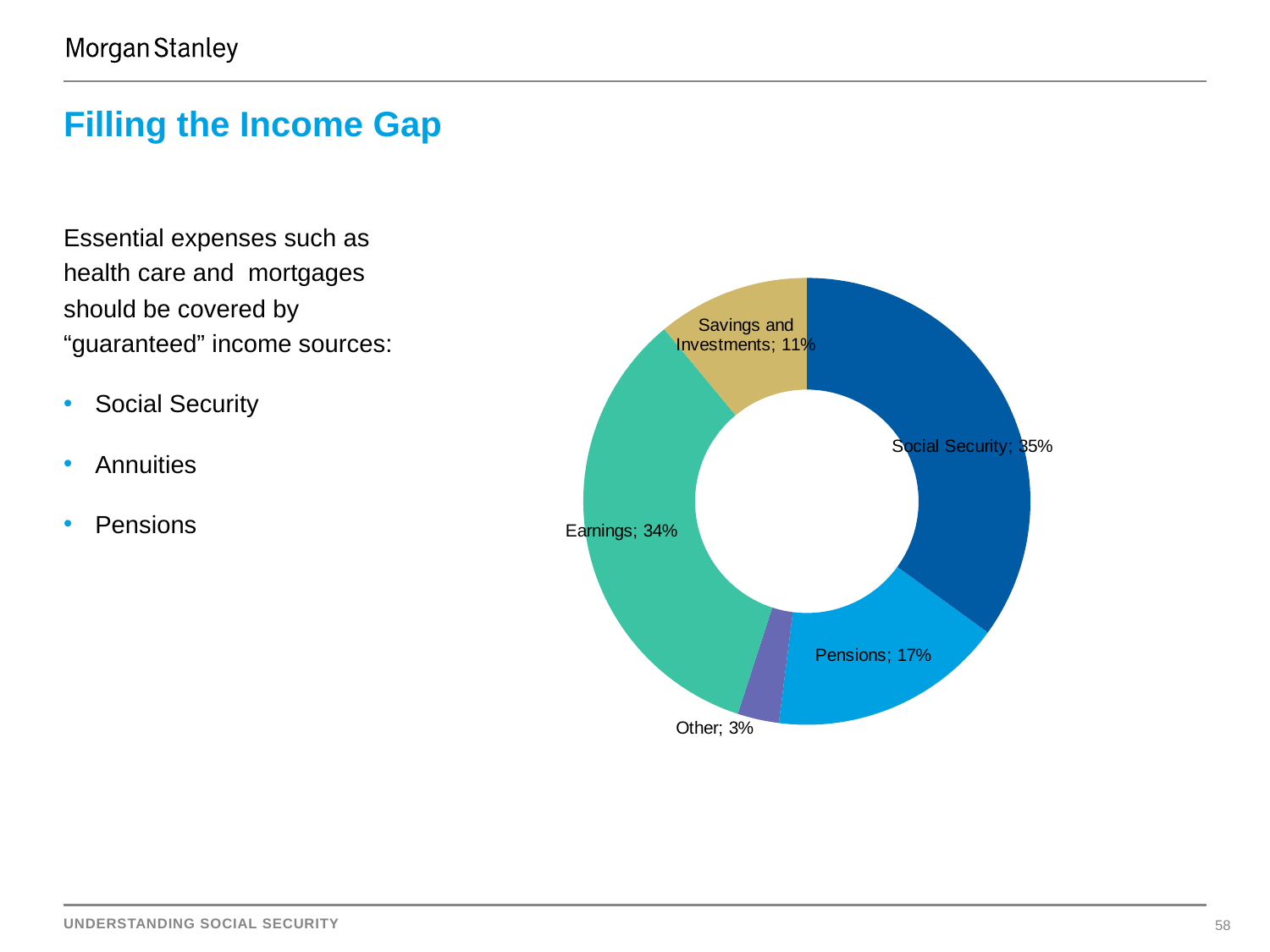
Which is larger, the Pensions slice or the Savings and Investments slice? Pensions What is the difference between the Social Security and Pensions shares? 18% What is the value shown for Savings and Investments? 11% What colour is the Earnings slice? Green What is the value shown for Other? 3% What is the difference between the Pensions and Savings and Investments shares? 6% How many categories are shown in the pie chart? 5 What share of the pie does Earnings represent? 34% What kind of chart is shown on the slide? Pie chart (doughnut) What is the value shown for Pensions? 17% Which category has the smallest slice of the pie? Other What share of the pie does Social Security represent? 35%